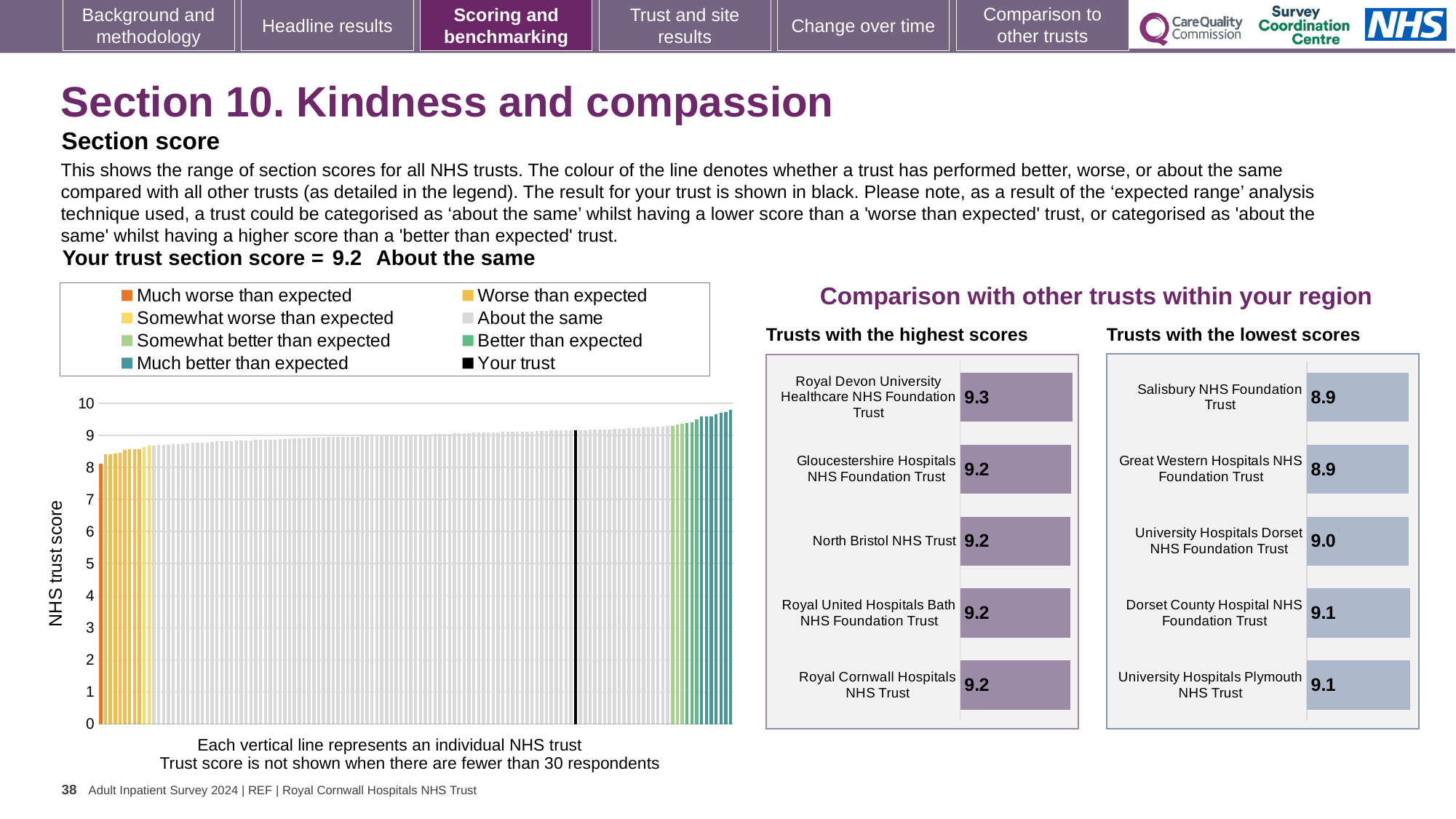
In the NHS trust score chart on the left, is the value of the leftmost bar greater or less than 9? less In the 'Trusts with the lowest scores' chart, what is the difference between the scores of Dorset County Hospital NHS Foundation Trust and Salisbury NHS Foundation Trust? 0.2 In the 'Trusts with the highest scores' chart, which trust has the highest score? Royal Devon University Healthcare NHS Foundation Trust How many entries does the legend of the NHS trust score chart on the left list? 8 What is the section score for your trust shown on the slide? 9.2 In the 'Trusts with the lowest scores' chart, what is the score for University Hospitals Dorset NHS Foundation Trust? 9.0 What kind of chart is the NHS trust score chart on the left of the slide? Bar chart In the NHS trust score chart on the left, do the values rise or fall from left to right along the x axis? Rise In the 'Trusts with the lowest scores' chart, which has the larger score: University Hospitals Dorset NHS Foundation Trust or University Hospitals Plymouth NHS Trust? University Hospitals Plymouth NHS Trust How many trusts are listed in the 'Trusts with the lowest scores' chart? 5 In the 'Trusts with the highest scores' chart, what is the score for Royal Devon University Healthcare NHS Foundation Trust? 9.3 In the 'Trusts with the highest scores' chart, what is the difference between the scores of Royal Devon University Healthcare NHS Foundation Trust and Royal Cornwall Hospitals NHS Trust? 0.1